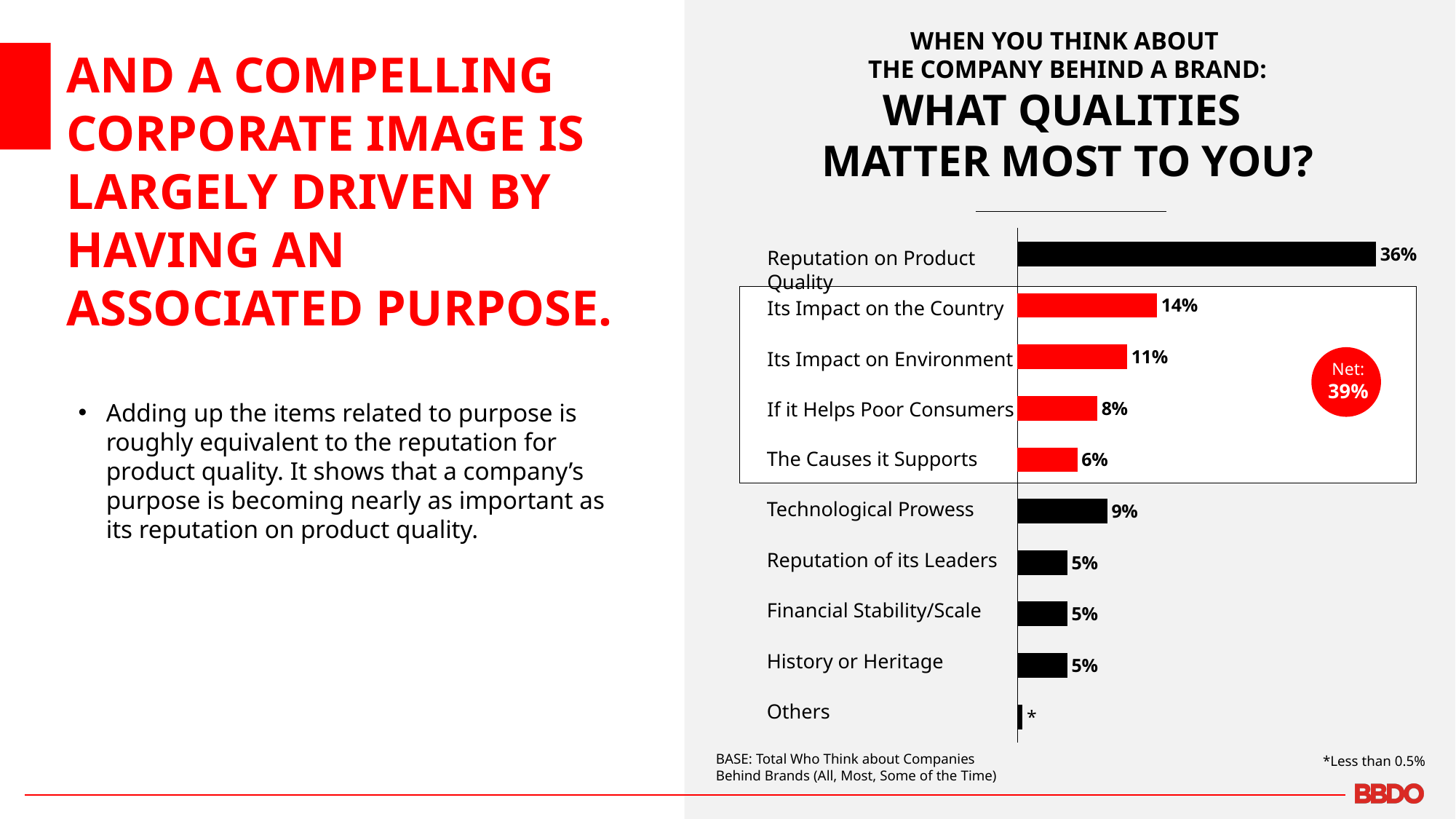
Which category has the highest value? Reputation on Product Quality Which category has the lowest value? Others What net value is shown in the red circle for the boxed purpose-related items? 39% What is the value for Reputation on Product Quality? 36% How many categories are shown in the chart? 10 What is the difference between Its Impact on Environment and If it Helps Poor Consumers? 3% What is the value for Its Impact on the Country? 14% What is the difference between Reputation on Product Quality and Its Impact on the Country? 22% What is the value for Technological Prowess? 9% What kind of chart is shown on the slide? Bar chart Which is larger, Technological Prowess or The Causes it Supports? Technological Prowess What is the value for The Causes it Supports? 6%